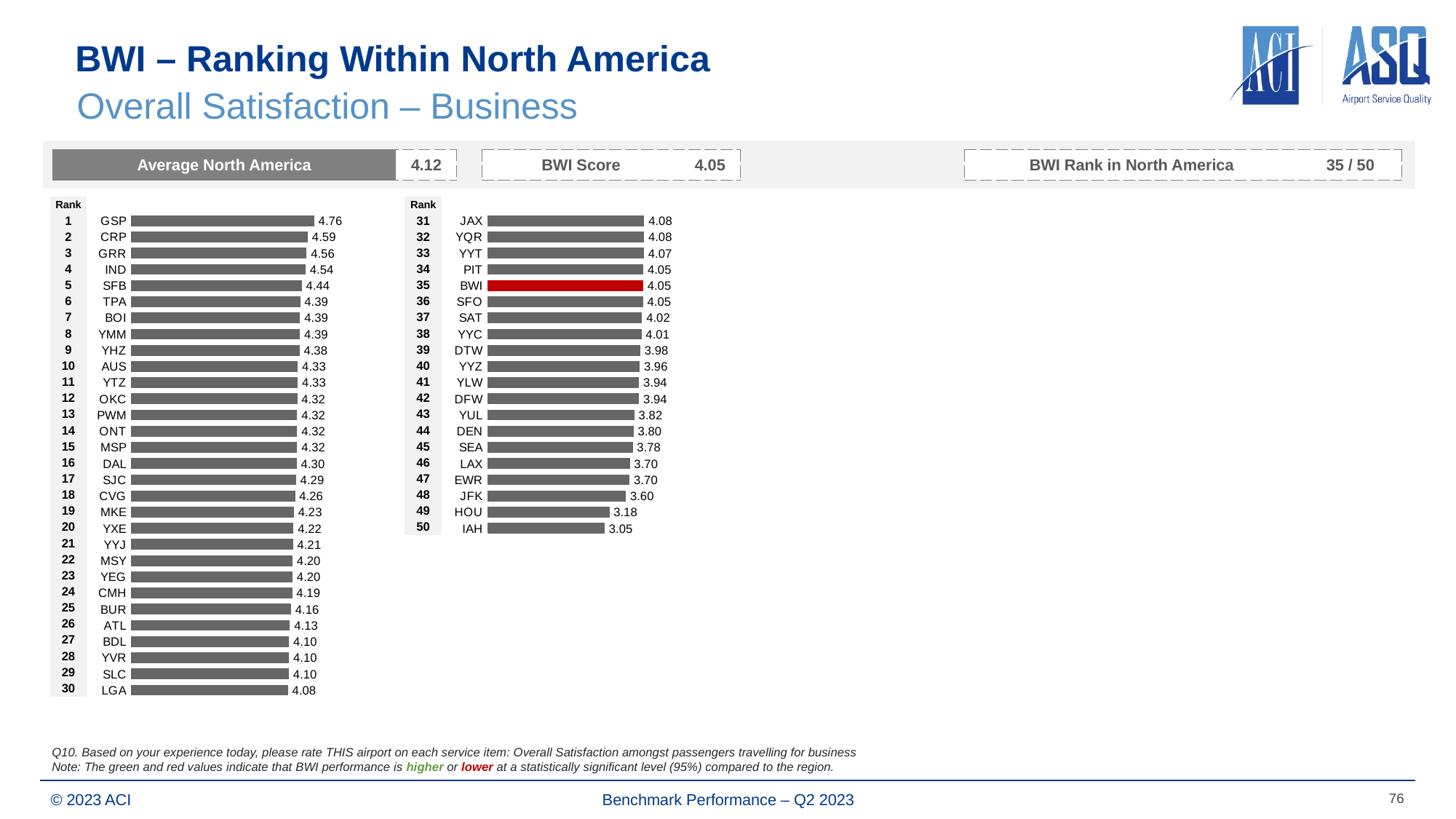
Which airport's bar is highlighted in red? BWI What is the score shown for HOU? 3.18 Which has the higher score, DEN or SEA? DEN What is the Overall Satisfaction – Business score for BWI? 4.05 How many airports are ranked in the chart? 50 How much lower is the BWI score than the Average North America score? 0.07 What is the score shown for ATL? 4.13 Which airport has the lowest Overall Satisfaction – Business score? IAH What is BWI's rank in North America according to the slide? 35 / 50 What is the difference between the highest score (GSP) and the lowest score (IAH)? 1.71 Which airport has the highest Overall Satisfaction – Business score? GSP What kind of chart is used to show the airport scores? Bar chart